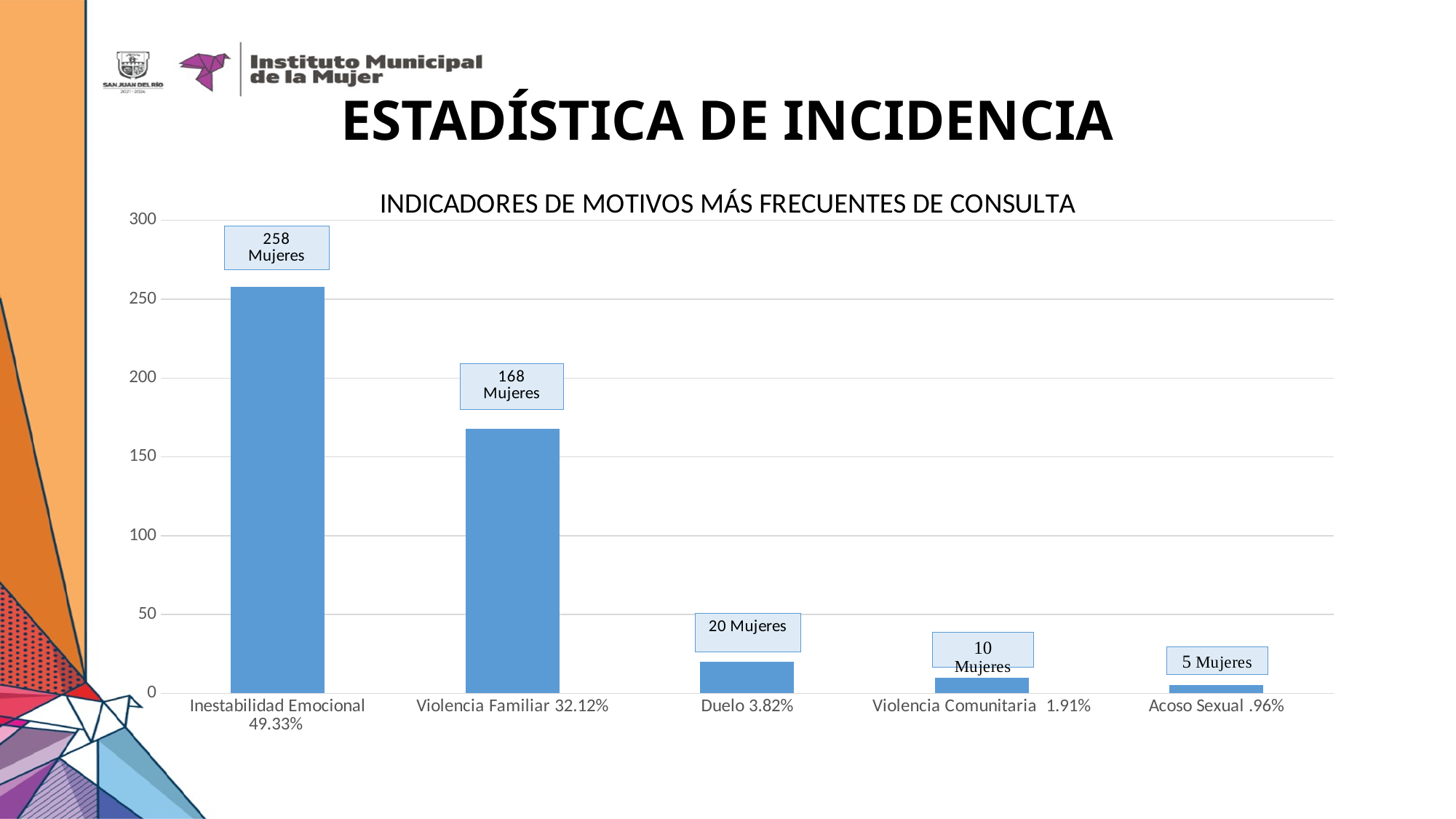
Which is larger, the value for Duelo or the value for Violencia Comunitaria? Duelo Which category has the highest value? Inestabilidad Emocional Which category has the lowest value? Acoso Sexual What is the title of the chart? INDICADORES DE MOTIVOS MÁS FRECUENTES DE CONSULTA What kind of chart is shown on the slide? Bar chart What is the value for Acoso Sexual? 5 Mujeres How many categories are shown on the x axis? 5 Is the value for Violencia Familiar greater or less than 150? greater What is the value for Violencia Familiar? 168 Mujeres What is the difference between the values for Inestabilidad Emocional and Violencia Familiar? 90 What is the value for Inestabilidad Emocional? 258 Mujeres What is the value for Duelo? 20 Mujeres